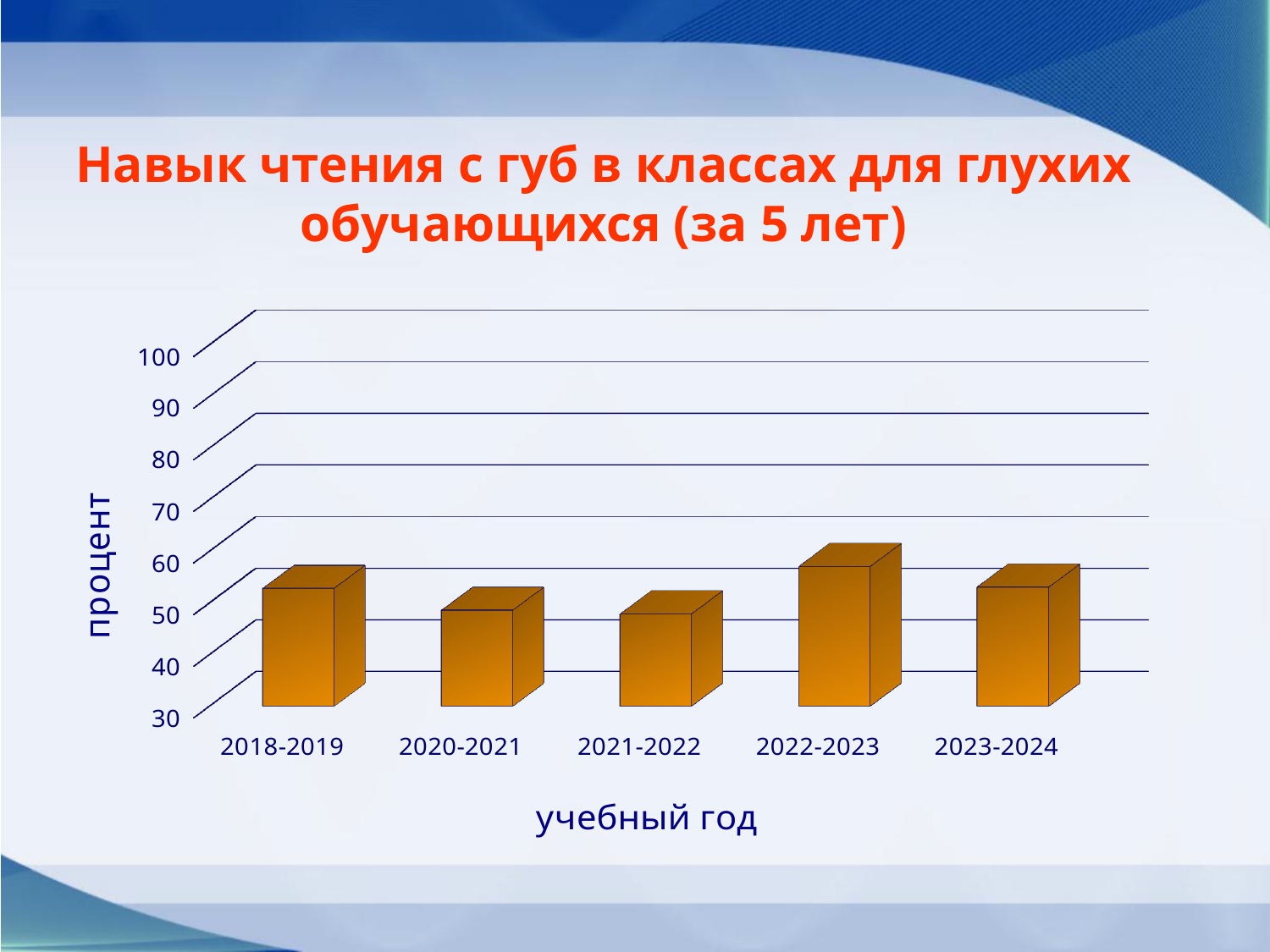
Which is larger, the value for 2022-2023 or the value for 2021-2022? 2022-2023 What is the label of the vertical axis? процент Is the value for 2022-2023 greater or less than 50? greater What kind of chart is shown on the slide? bar chart Did the value rise or fall from 2021-2022 to 2022-2023? rise Is the value for 2020-2021 greater or less than 70? less Which academic year has the highest bar? 2022-2023 Is the value for 2018-2019 greater or less than 40? greater Which is larger, the value for 2022-2023 or the value for 2020-2021? 2022-2023 What is the label of the horizontal axis? учебный год How many academic years (categories) are plotted on the chart? 5